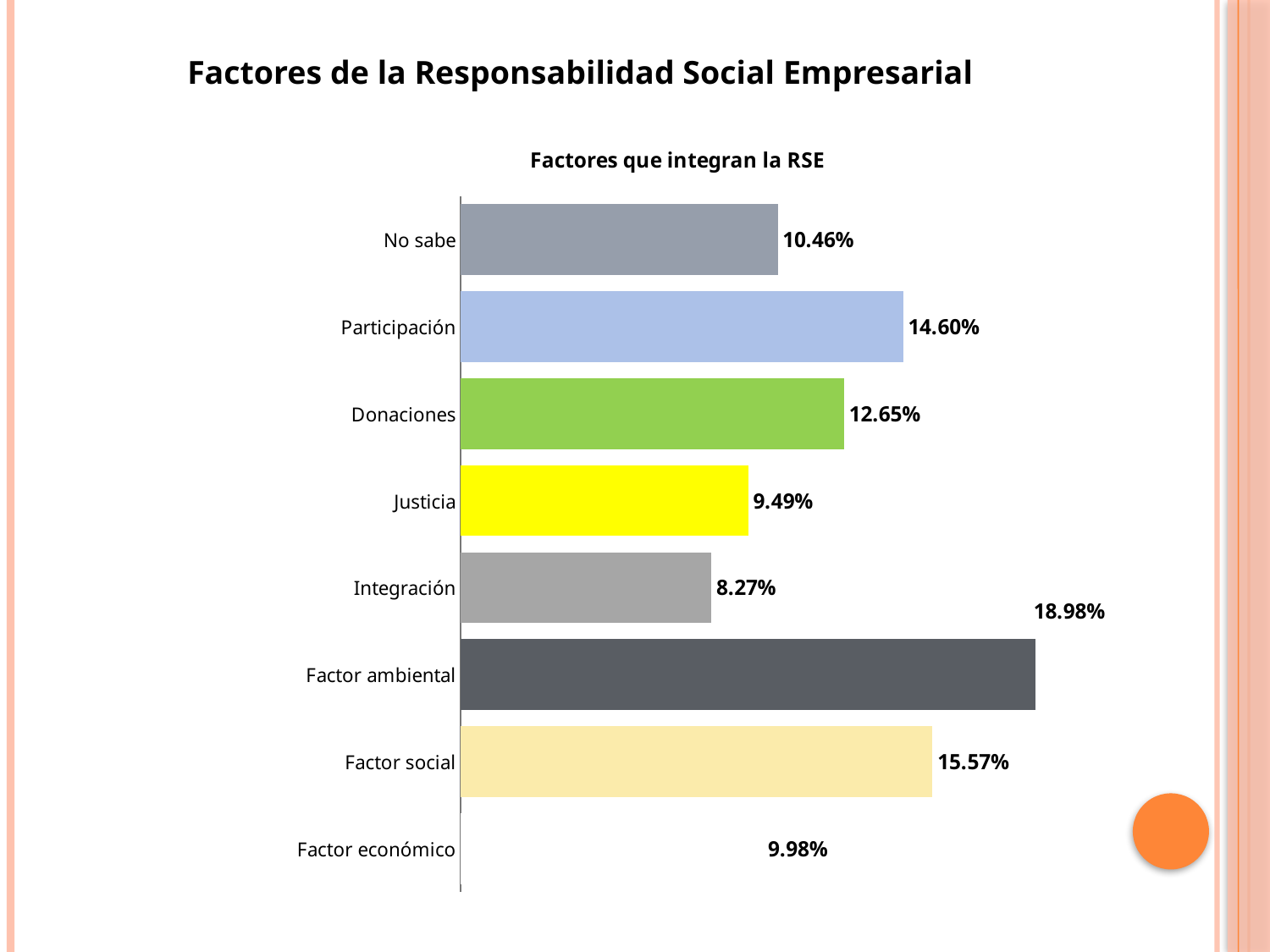
What is the value for Participación? 14.60% How many categories are shown in the chart? 8 Which is larger, Donaciones or No sabe? Donaciones What is the difference between Factor ambiental and Factor social? 3.41% What is the difference between Factor social and Participación? 0.97% What is the value for Factor ambiental? 18.98% What is the value for Factor económico? 9.98% Which category has the highest value? Factor ambiental What is the title of the chart? Factores que integran la RSE Which category has the lowest value? Integración What kind of chart is this? Bar chart What is the value for Integración? 8.27%